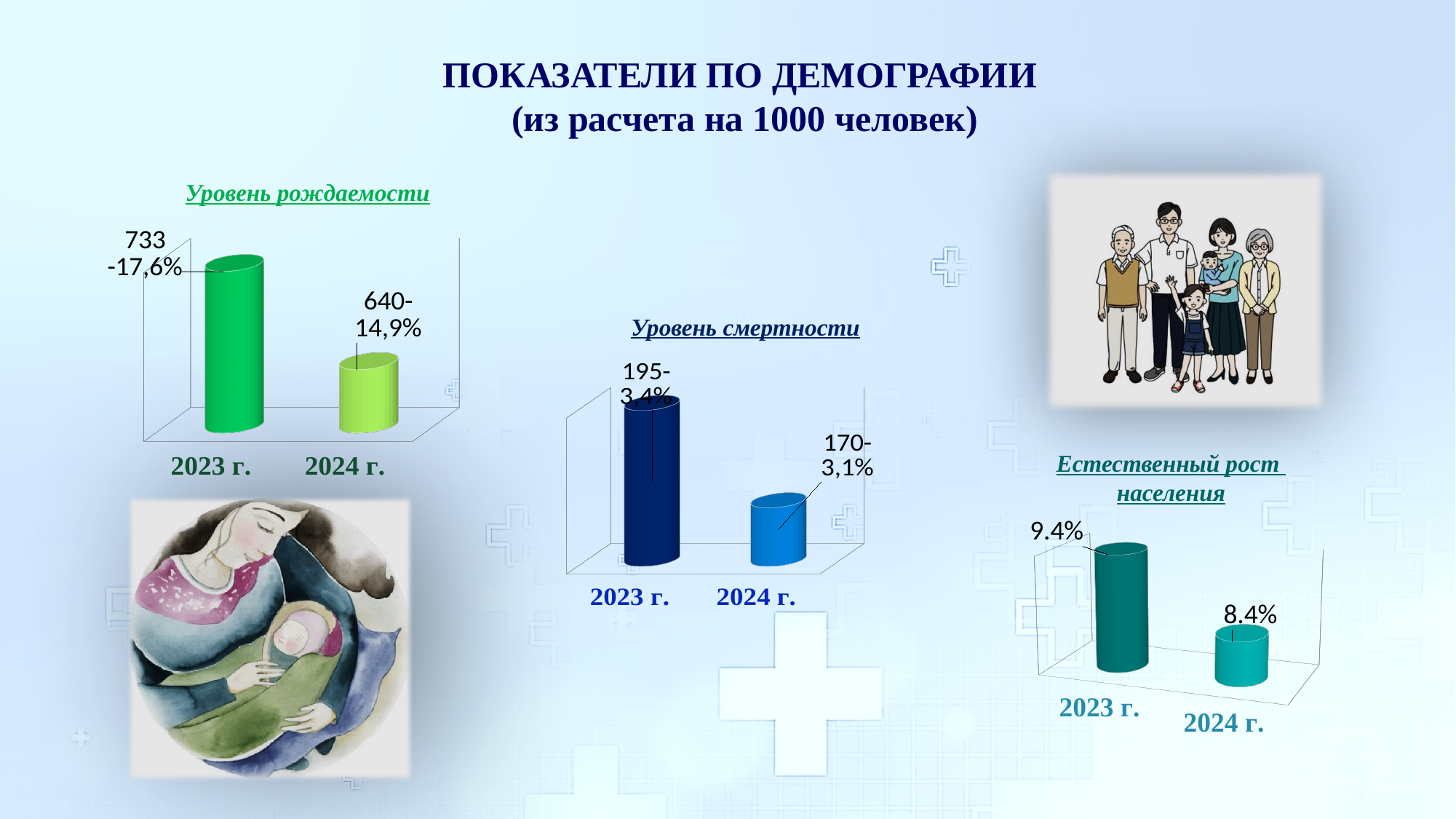
In the 'Уровень рождаемости' chart, which year has the taller bar? 2023 г. In the 'Естественный рост населения' chart, do the values rise or fall from 2023 г. to 2024 г.? fall In the 'Уровень смертности' chart, which year has the lower bar? 2024 г. In the 'Естественный рост населения' chart, what is the value for 2024 г.? 8.4% What kind of chart is the 'Естественный рост населения' chart? bar chart In the 'Уровень рождаемости' chart, what is the data label on the 2023 г. bar? 733 -17,6% In the 'Уровень рождаемости' chart, what is the data label on the 2024 г. bar? 640-14,9% In the 'Уровень смертности' chart, what is the data label on the 2024 г. bar? 170-3,1% In the 'Уровень смертности' chart, what is the data label on the 2023 г. bar? 195-3,4% How many bars does the 'Уровень смертности' chart have? 2 In the 'Естественный рост населения' chart, what is the difference between the 2023 г. and 2024 г. values? 1.0% In the 'Естественный рост населения' chart, what is the value for 2023 г.? 9.4%